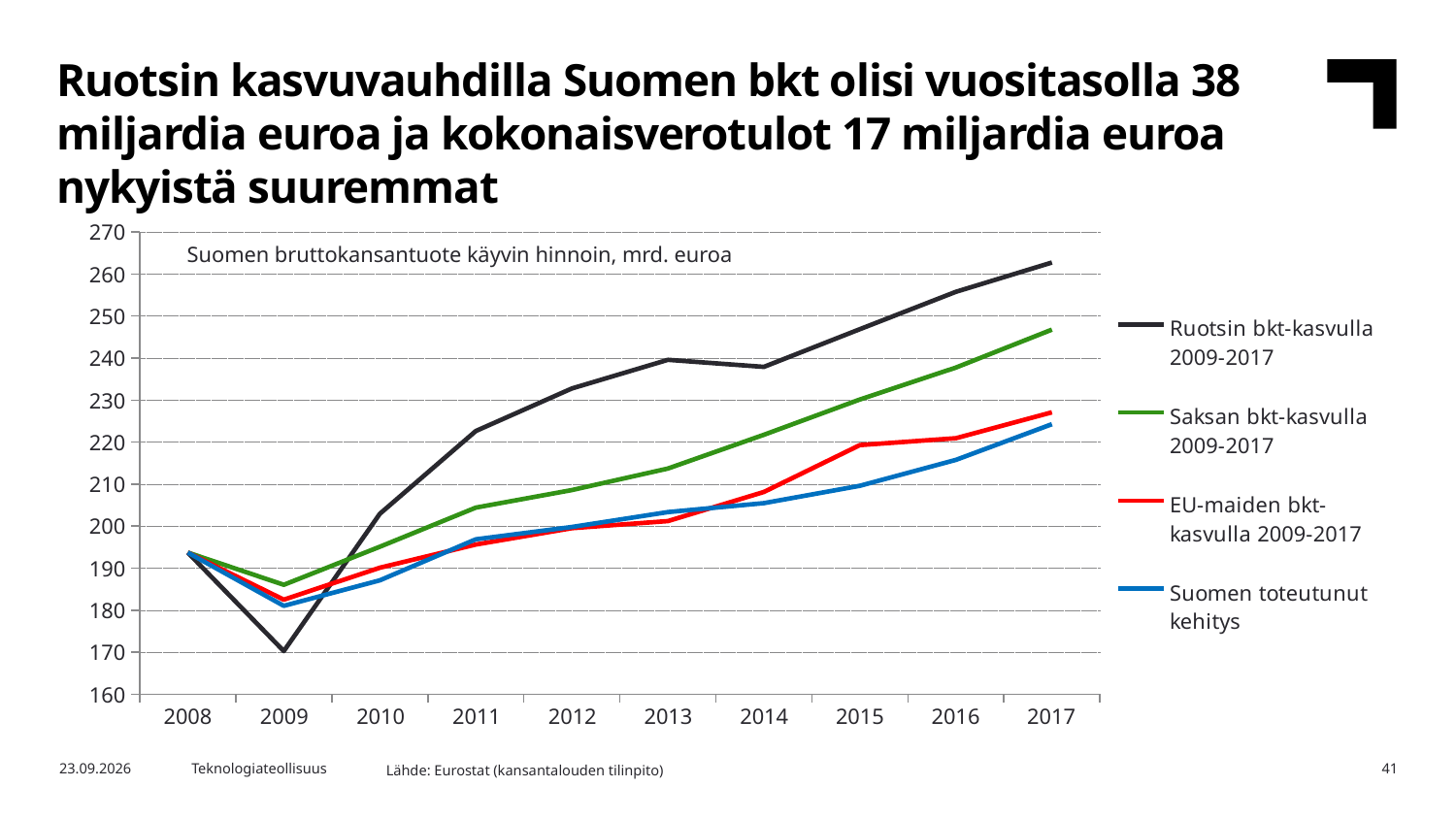
Is the value for Suomen toteutunut kehitys in 2017 greater or less than 230? less Does the Ruotsin bkt-kasvulla 2009-2017 line rise or fall from 2009 to 2017? rise What is the text shown inside the chart area describing the data? Suomen bruttokansantuote käyvin hinnoin, mrd. euroa How many years are shown on the x axis? 10 Is the value for Ruotsin bkt-kasvulla 2009-2017 in 2009 greater or less than 180? less In 2017, which is larger: Saksan bkt-kasvulla 2009-2017 or EU-maiden bkt-kasvulla 2009-2017? Saksan bkt-kasvulla 2009-2017 Is the value for Ruotsin bkt-kasvulla 2009-2017 in 2017 greater or less than 250? greater How many series does the legend list? 4 Which series has the lowest value in 2009? Ruotsin bkt-kasvulla 2009-2017 What type of chart is shown on the slide? line chart Which series has the highest value in 2017? Ruotsin bkt-kasvulla 2009-2017